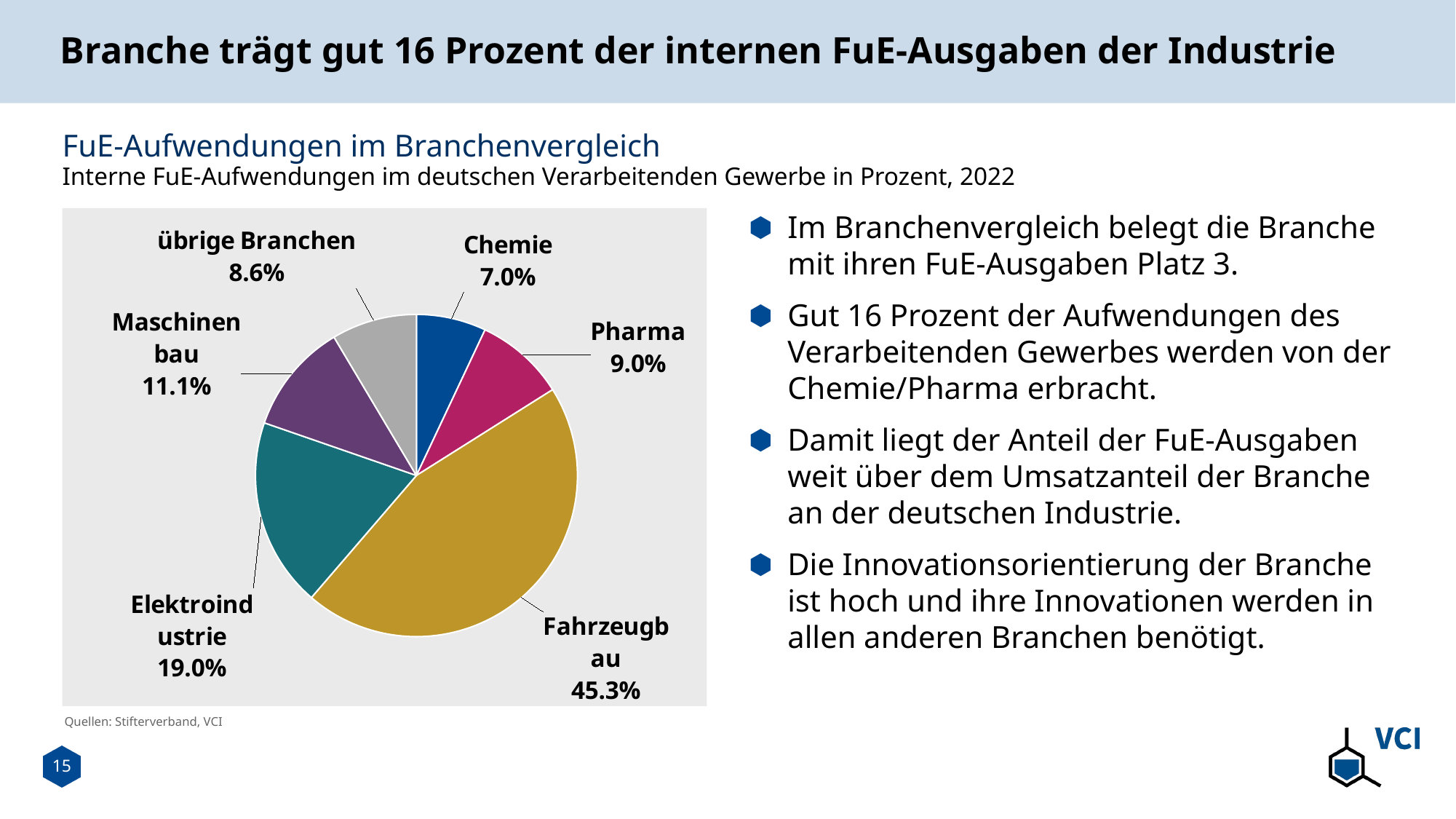
What is the difference between the shares of Elektroindustrie and Maschinenbau? 7.9 percentage points What share is shown for Maschinenbau? 11.1% How many slices does the pie chart have? 6 What is the combined share of Chemie and Pharma? 16.0% Which is larger, the share for Pharma or the share for übrige Branchen? Pharma Which category has the smallest slice of the pie? Chemie What is the value shown for Pharma? 9.0% What is the value for Elektroindustrie? 19.0% Which category has the largest slice of the pie? Fahrzeugbau What percentage is shown for Fahrzeugbau? 45.3% What share of the pie does Chemie hold? 7.0% What kind of chart is shown on the slide? Pie chart